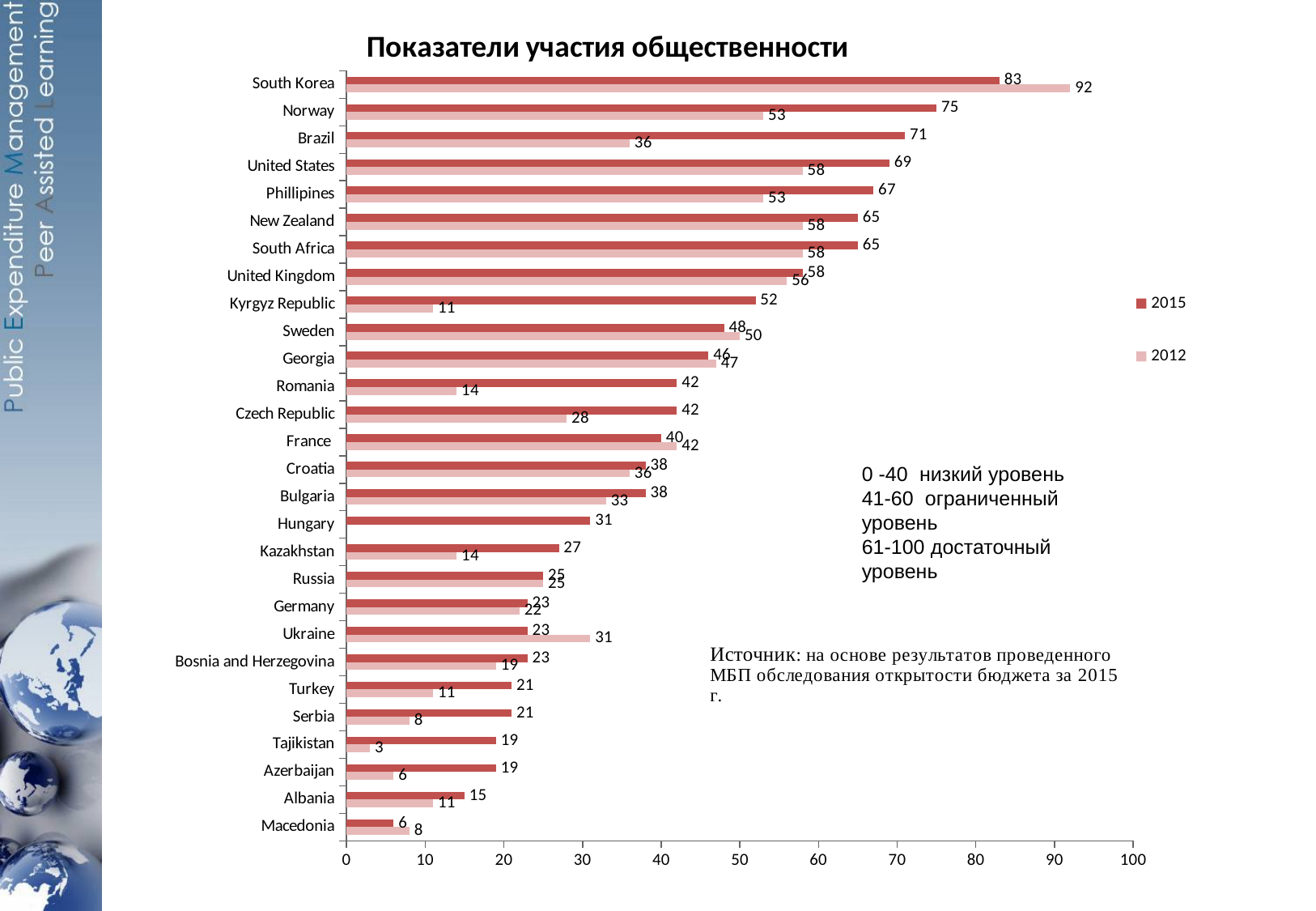
What is the 2015 value for Brazil? 71 What is the 2012 value for Kyrgyz Republic? 11 What is the title of the chart? Показатели участия общественности How many countries are shown on the chart? 28 Which series is shown in the darker red colour? 2015 Which is larger for Ukraine, the 2015 value or the 2012 value? 2012 What is the 2012 value for South Korea? 92 What kind of chart is shown on the slide? Bar chart How many series does the legend list? 2 What is the difference between the 2015 and 2012 values for Romania? 28 Which country has the lowest 2012 value? Tajikistan Which country has the highest 2015 value? South Korea